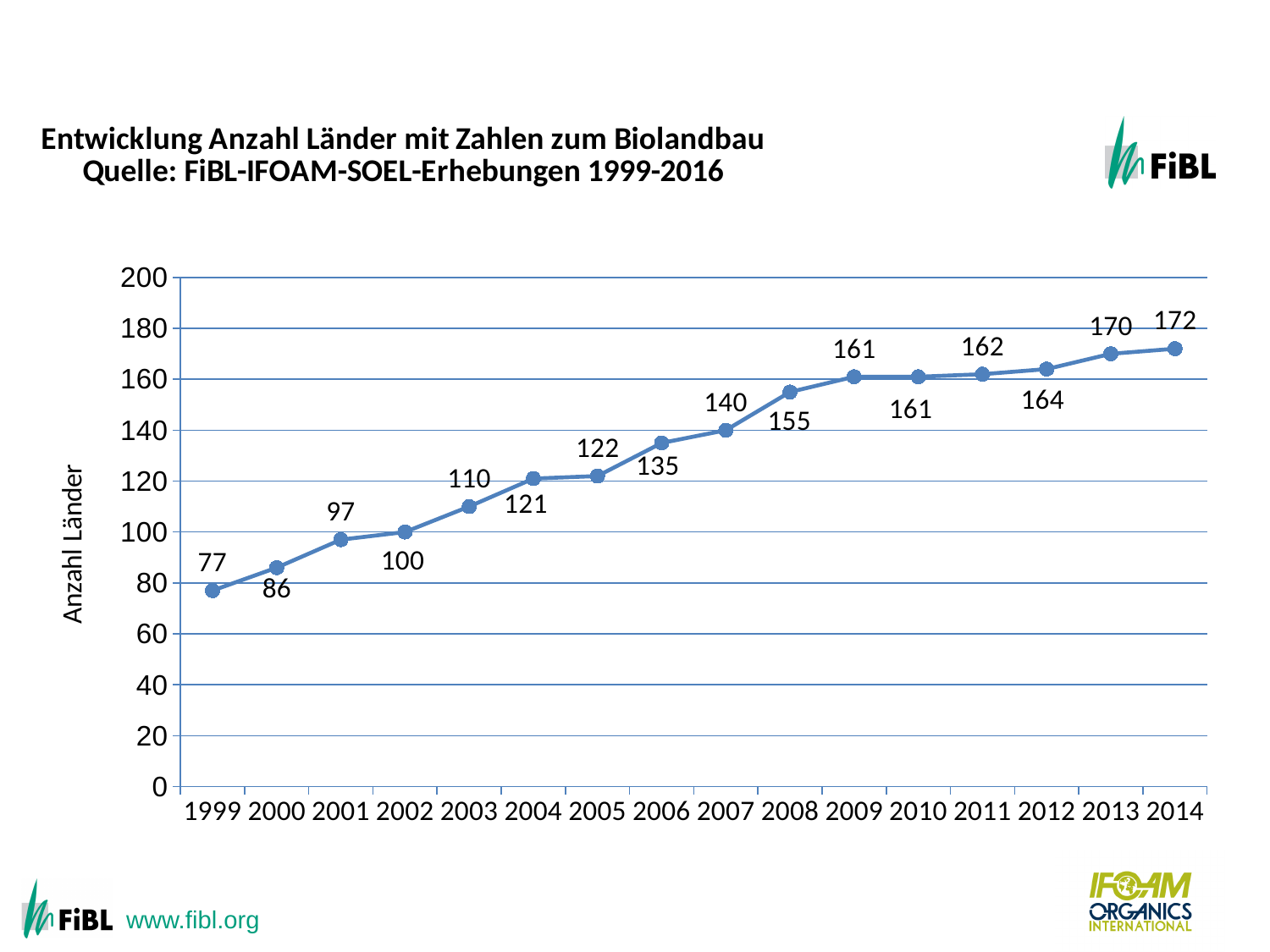
Which is larger, the value for 2003 or the value for 2005? 2005 What is the difference between the values for 2007 and 2006? 5 What is the value for 2014? 172 Which year has the lowest number of countries? 1999 What is the number of countries (Anzahl Länder) in 1999? 77 Which year has the highest number of countries? 2014 What kind of chart is shown on the slide? line chart What is the value for 2008? 155 How many years (data points) are plotted on the chart? 16 What is the difference between the values for 2014 and 1999? 95 Do the values generally rise or fall from 1999 to 2014? rise What is the label of the y axis? Anzahl Länder